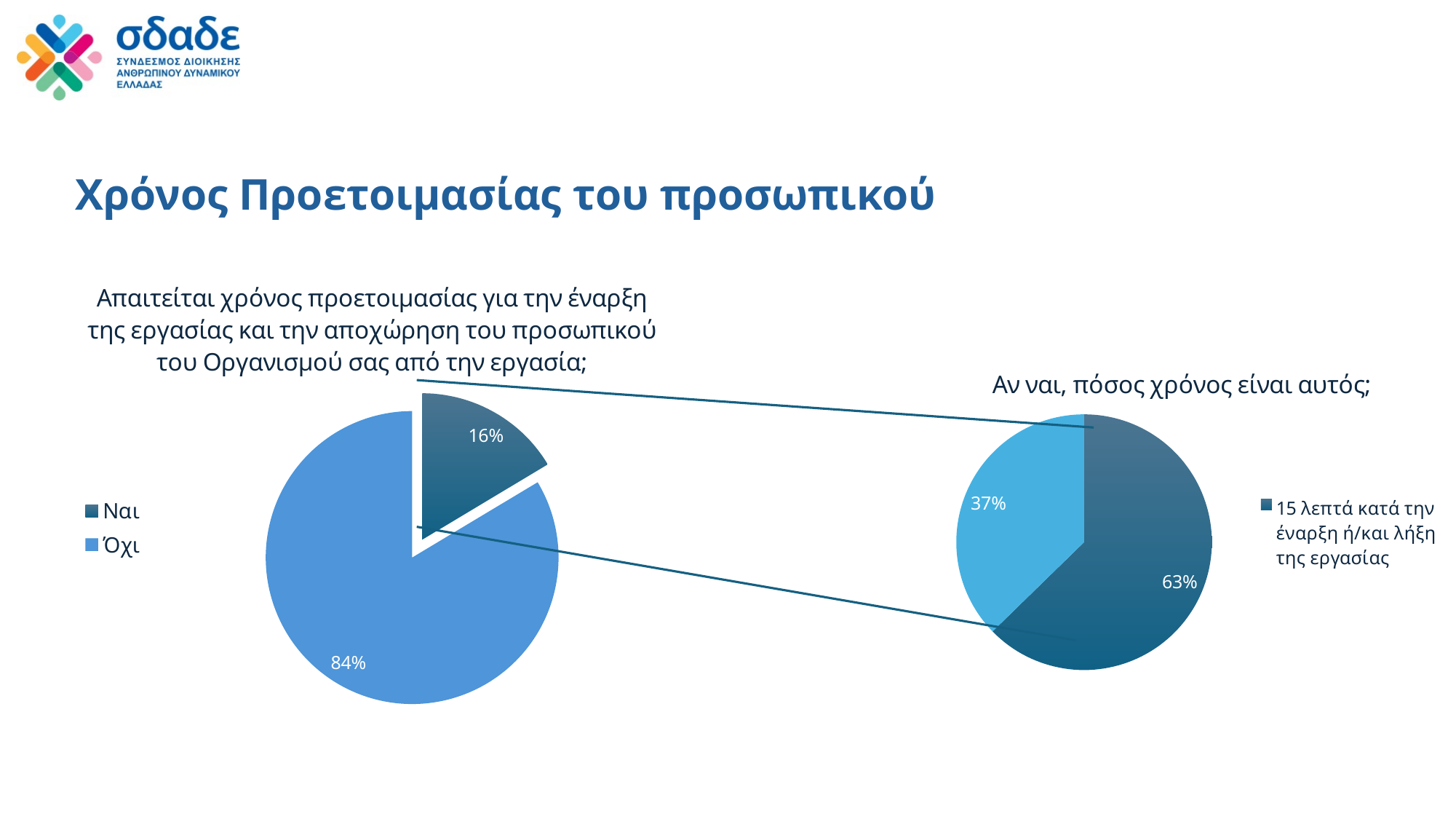
In the left pie chart, which category has the smallest slice? Ναι In the right pie chart (Αν ναι, πόσος χρόνος είναι αυτός;), what share is labelled '15 λεπτά κατά την έναρξη ή/και λήξη της εργασίας'? 63% In the left pie chart, what share of respondents answered Ναι? 16% In the right pie chart (Αν ναι, πόσος χρόνος είναι αυτός;), what share does the light blue slice represent? 37% In the left pie chart, what is the difference in percentage points between Όχι and Ναι? 68 How many categories does the legend of the left pie chart list? 2 In the left pie chart, what share of respondents answered Όχι? 84% In the right pie chart (Αν ναι, πόσος χρόνος είναι αυτός;), which is larger: the slice for '15 λεπτά κατά την έναρξη ή/και λήξη της εργασίας' or the light blue slice? 15 λεπτά κατά την έναρξη ή/και λήξη της εργασίας What is the title of the slide? Χρόνος Προετοιμασίας του προσωπικού In the left pie chart, which category has the largest slice? Όχι How many slices does the right pie chart (Αν ναι, πόσος χρόνος είναι αυτός;) have? 2 What kind of chart is the left chart on the slide? pie chart